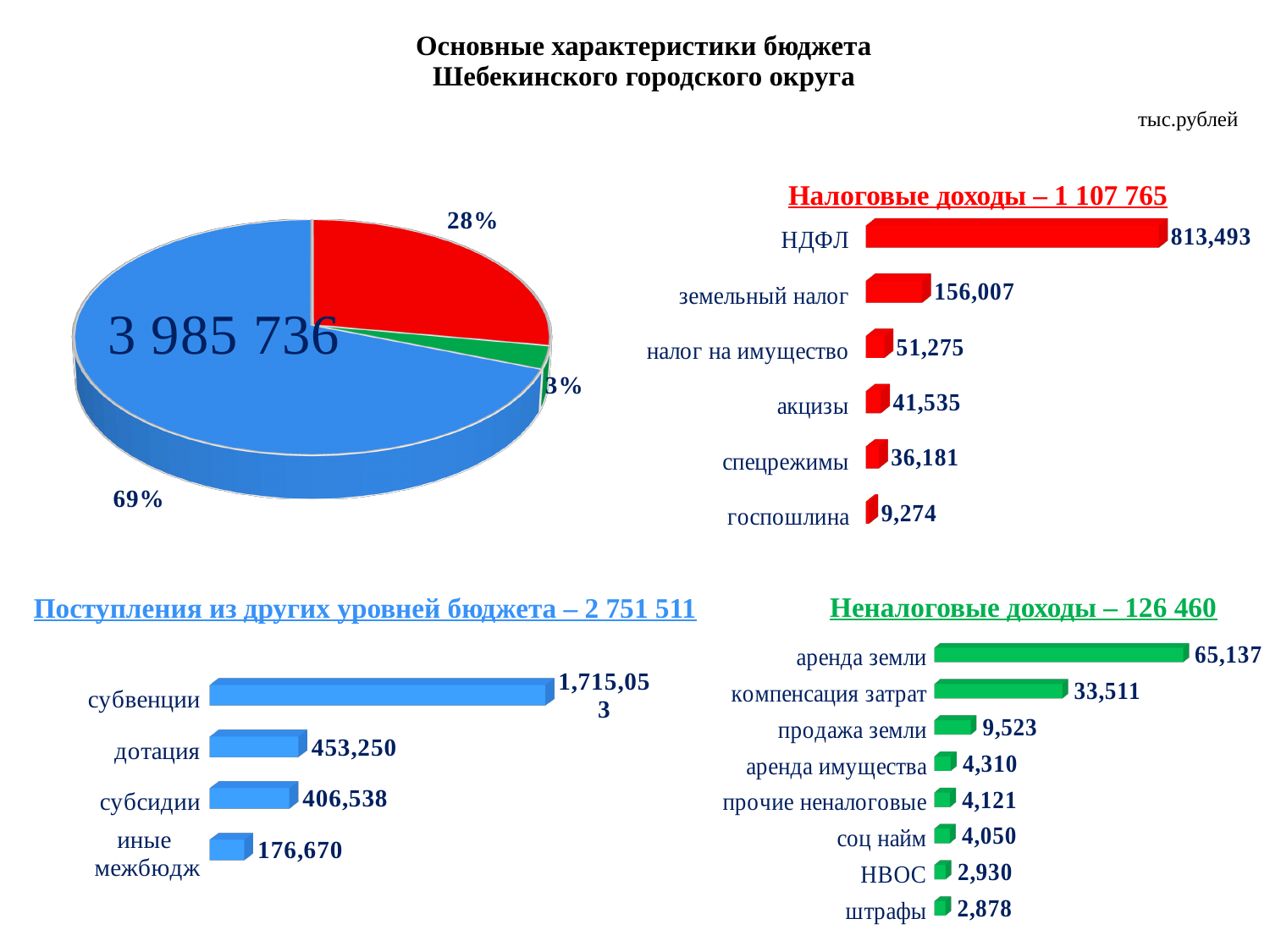
What kind of chart is the 'Неналоговые доходы – 126 460' chart? bar chart In the pie chart on the left, what share does the red slice represent? 28% In the 'Неналоговые доходы – 126 460' chart, what is the difference between аренда земли and продажа земли? 55,614 In the 'Неналоговые доходы – 126 460' chart, how many categories are shown? 8 In the 'Неналоговые доходы – 126 460' chart, what is the value for компенсация затрат? 33,511 In the 'Поступления из других уровней бюджета – 2 751 511' chart, which category has the highest value? субвенции In the 'Поступления из других уровней бюджета – 2 751 511' chart, what is the value for дотация? 453,250 In the 'Налоговые доходы – 1 107 765' chart, which category has the lowest value? госпошлина In the 'Налоговые доходы – 1 107 765' chart, how many categories are shown? 6 In the 'Налоговые доходы – 1 107 765' chart, what is the value for НДФЛ? 813,493 In the 'Поступления из других уровней бюджета – 2 751 511' chart, which is larger: дотация or субсидии? дотация In the 'Налоговые доходы – 1 107 765' chart, what is the difference between земельный налог and налог на имущество? 104,732